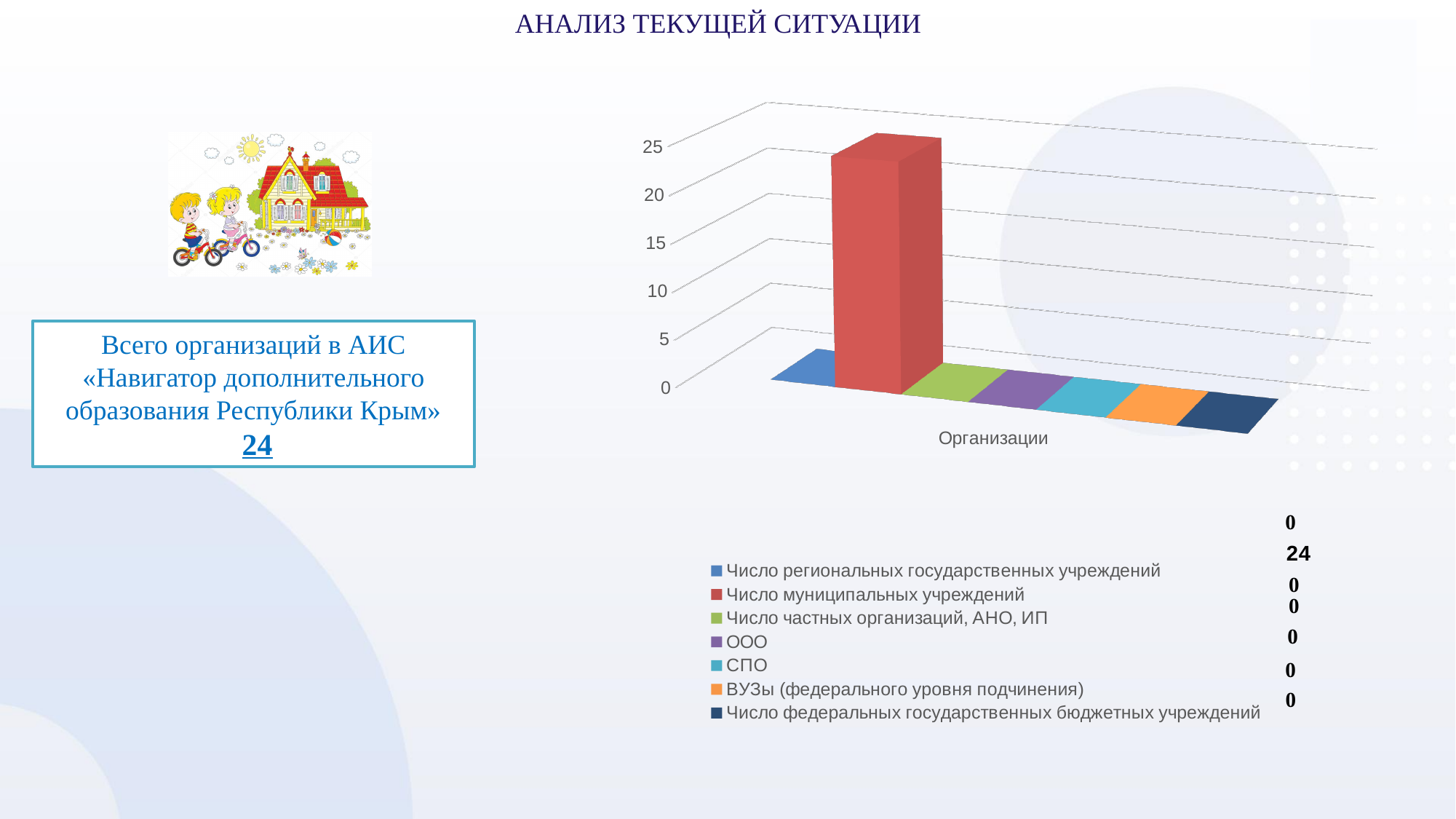
What is the value for ООО? 0 What is the category label shown on the x axis of the chart? Организации Which series has the highest value in the chart? Число муниципальных учреждений What is the difference between the value for Число муниципальных учреждений and the value for ВУЗы (федерального уровня подчинения)? 24 What is the value for Число муниципальных учреждений? 24 What is the value for Число региональных государственных учреждений? 0 What is the value for Число федеральных государственных бюджетных учреждений? 0 Is the value for Число муниципальных учреждений greater or less than 20? greater How many series does the chart legend list? 7 Which is larger: the value for Число муниципальных учреждений or the value for СПО? Число муниципальных учреждений What colour is the bar for Число муниципальных учреждений? red What kind of chart is shown on the slide? bar chart